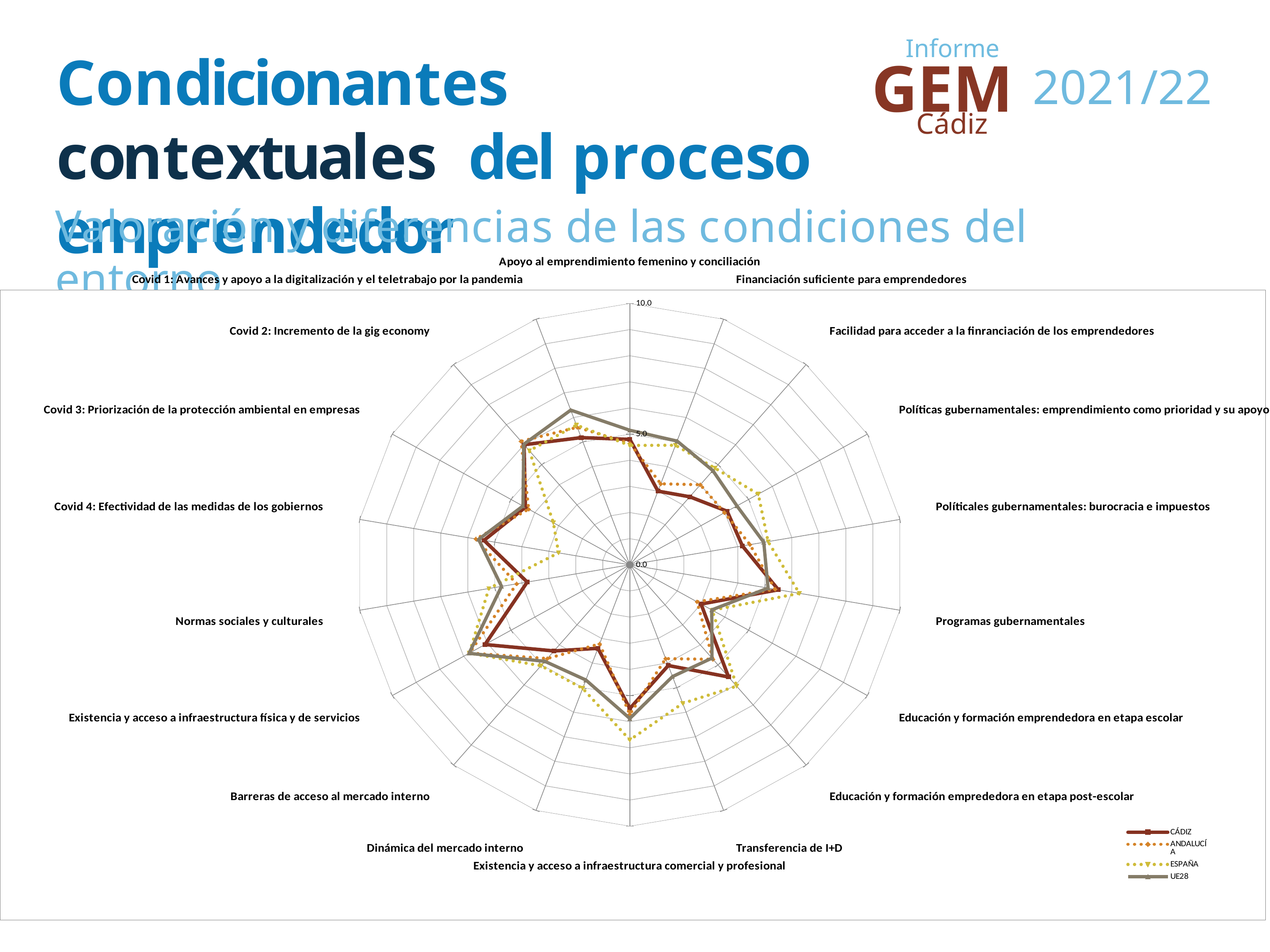
Is the CÁDIZ value for 'Covid 4: Efectividad de las medidas de los gobiernos' greater or less than 5.0? greater What kind of chart is shown on the slide? Radar chart Is the ESPAÑA value for 'Covid 4: Efectividad de las medidas de los gobiernos' greater or less than 5.0? less For 'Financiación suficiente para emprendedores', which series has the larger value, CÁDIZ or UE28? UE28 Which series are listed in the legend of the radar chart? CÁDIZ, ANDALUCÍA, ESPAÑA, UE28 How many categories (axes) does the radar chart have? 18 How many series does the legend of the radar chart list? 4 What is the maximum value shown on the radar chart's axis scale? 10.0 Is the ESPAÑA value for 'Existencia y acceso a infraestructura comercial y profesional' greater or less than 5.0? greater For 'Covid 4: Efectividad de las medidas de los gobiernos', which series has the larger value, CÁDIZ or ESPAÑA? CÁDIZ